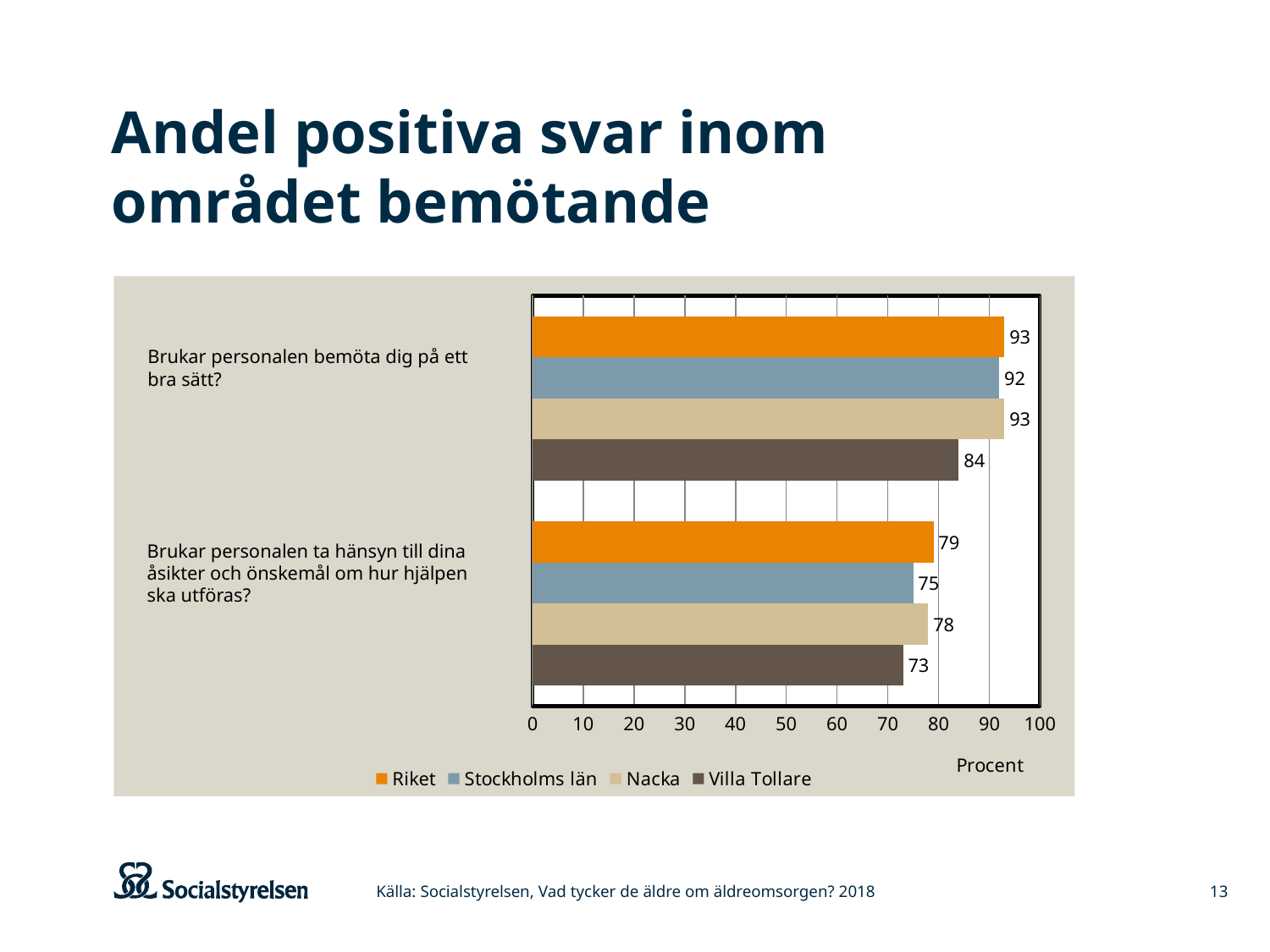
What is the value for Riket on the question "Brukar personalen ta hänsyn till dina åsikter och önskemål om hur hjälpen ska utföras?"? 79 Which series has the lowest value on the question "Brukar personalen bemöta dig på ett bra sätt?"? Villa Tollare Which is larger: the Nacka value or the Villa Tollare value on the question "Brukar personalen ta hänsyn till dina åsikter och önskemål om hur hjälpen ska utföras?"? Nacka What kind of chart is shown on the slide? Bar chart How many series does the legend list? 4 Which series has the highest value on the question "Brukar personalen ta hänsyn till dina åsikter och önskemål om hur hjälpen ska utföras?"? Riket What is the value for Stockholms län on the question "Brukar personalen ta hänsyn till dina åsikter och önskemål om hur hjälpen ska utföras?"? 75 What is the difference between the Nacka and Stockholms län values on the question "Brukar personalen ta hänsyn till dina åsikter och önskemål om hur hjälpen ska utföras?"? 3 Is the value for Villa Tollare on the question "Brukar personalen bemöta dig på ett bra sätt?" greater or less than 80? greater What is the label on the horizontal axis of the chart? Procent What is the difference between the Riket and Villa Tollare values on the question "Brukar personalen bemöta dig på ett bra sätt?"? 9 What is the value for Villa Tollare on the question "Brukar personalen bemöta dig på ett bra sätt?"? 84